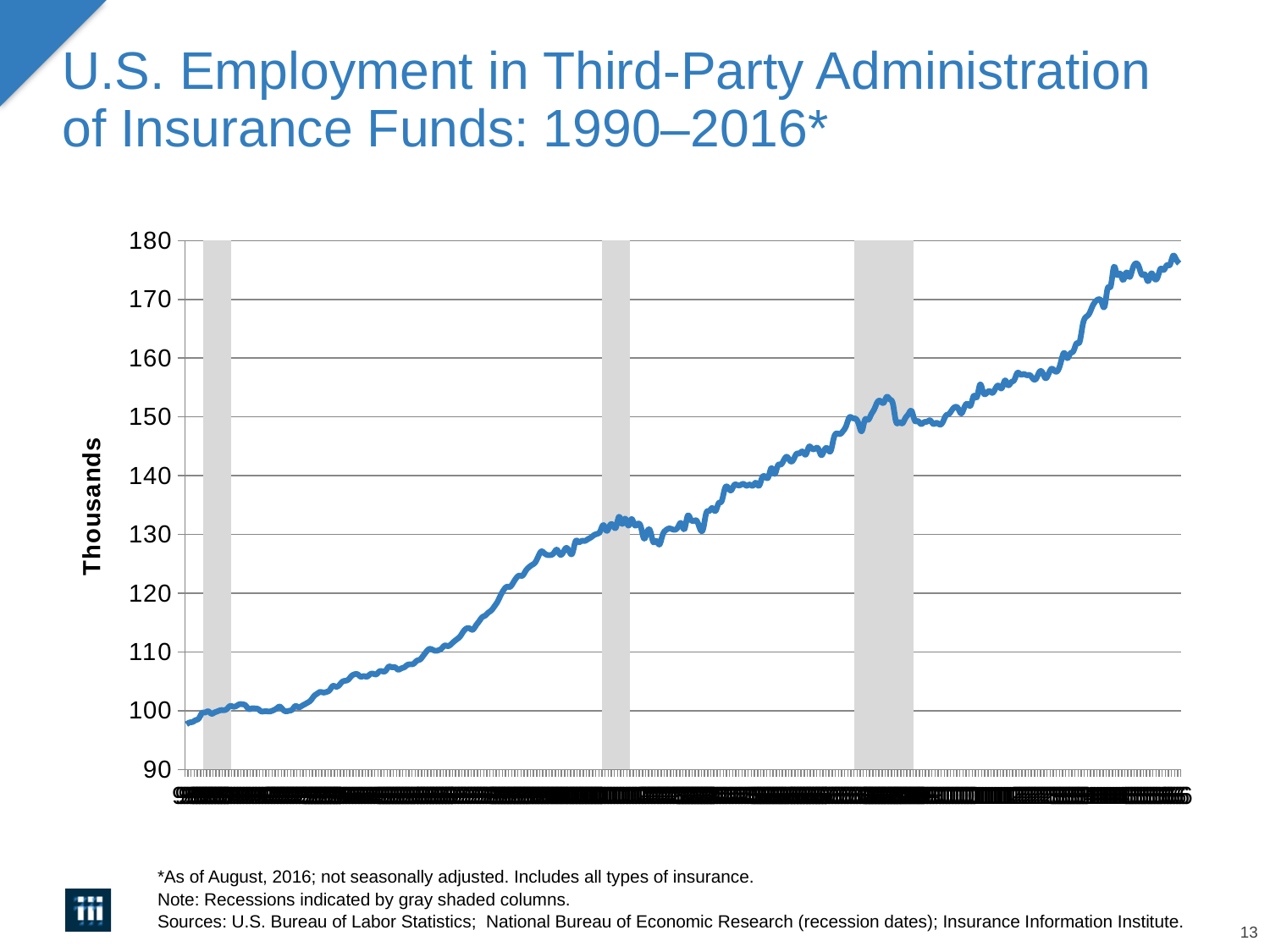
What kind of chart is shown on the slide? line chart Overall, do the values rise or fall from the left of the chart to the right? rise Is the value of the line during the third gray shaded column greater or less than 140? greater Is the value at the left end of the line (1990) greater or less than 110? less Is the value of the line during the second gray shaded column greater or less than 140? less What is the title of the chart? U.S. Employment in Third-Party Administration of Insurance Funds: 1990–2016* What is the label on the vertical axis of the chart? Thousands